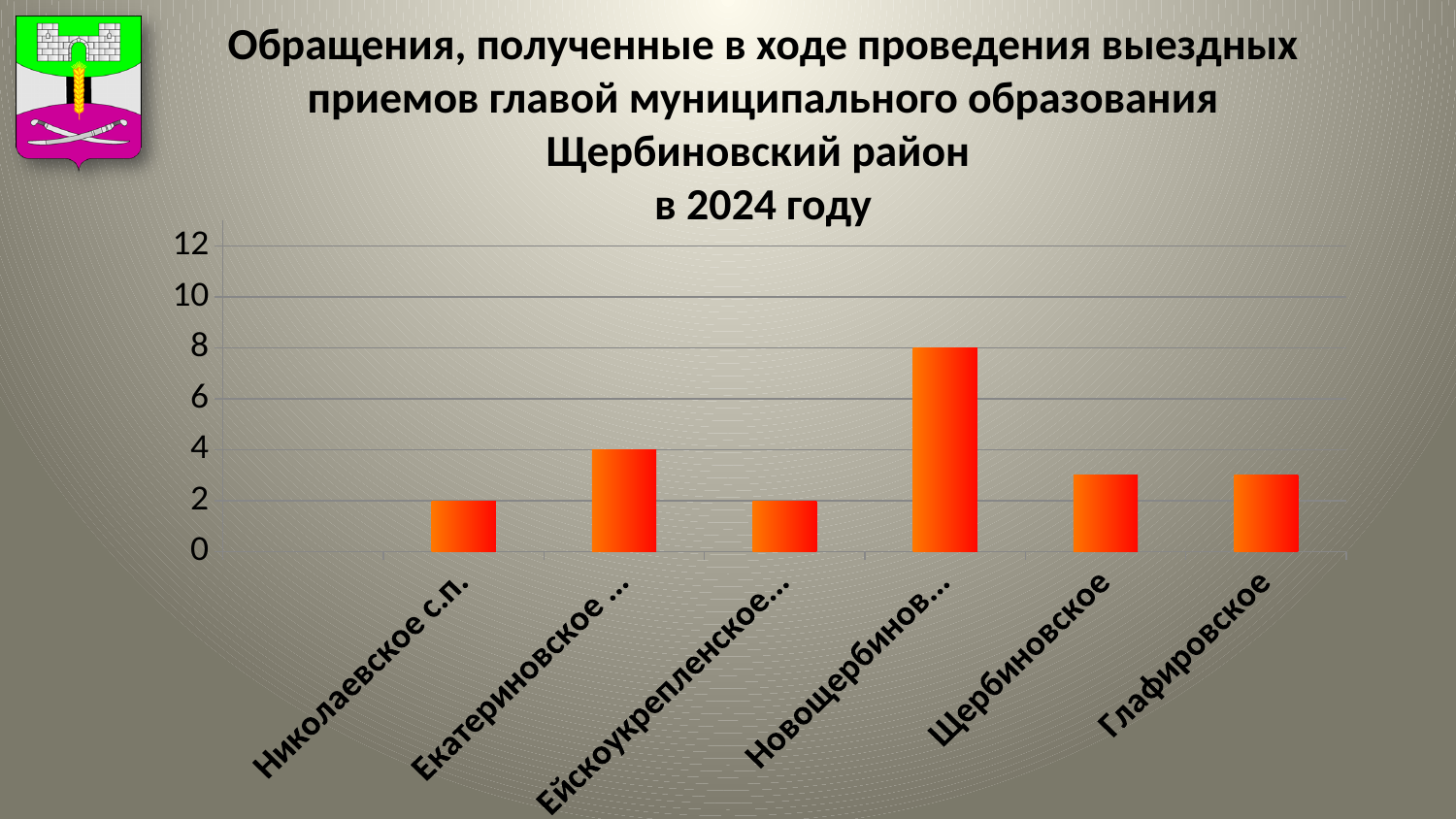
Is the value for Щербиновское greater or less than 2? greater How many categories (settlements) are shown on the x axis of the chart? 6 Which is larger: the value for Николаевское с.п. or the value for the category beginning with Екатериновское? Екатериновское … What is the value for Николаевское с.п.? 2 Which category has the highest value in the chart? Новощербинов… What is the difference between the value for the category beginning with Екатериновское and the value for Николаевское с.п.? 2 What year does the chart title say the data refers to? 2024 What is the difference between the value for the category beginning with Новощербинов and the value for the category beginning with Екатериновское? 4 What is the value for the category whose label begins with Екатериновское? 4 What kind of chart is shown on the slide? bar chart Is the value for Глафировское greater or less than 4? less What is the value for the category whose label begins with Новощербинов? 8